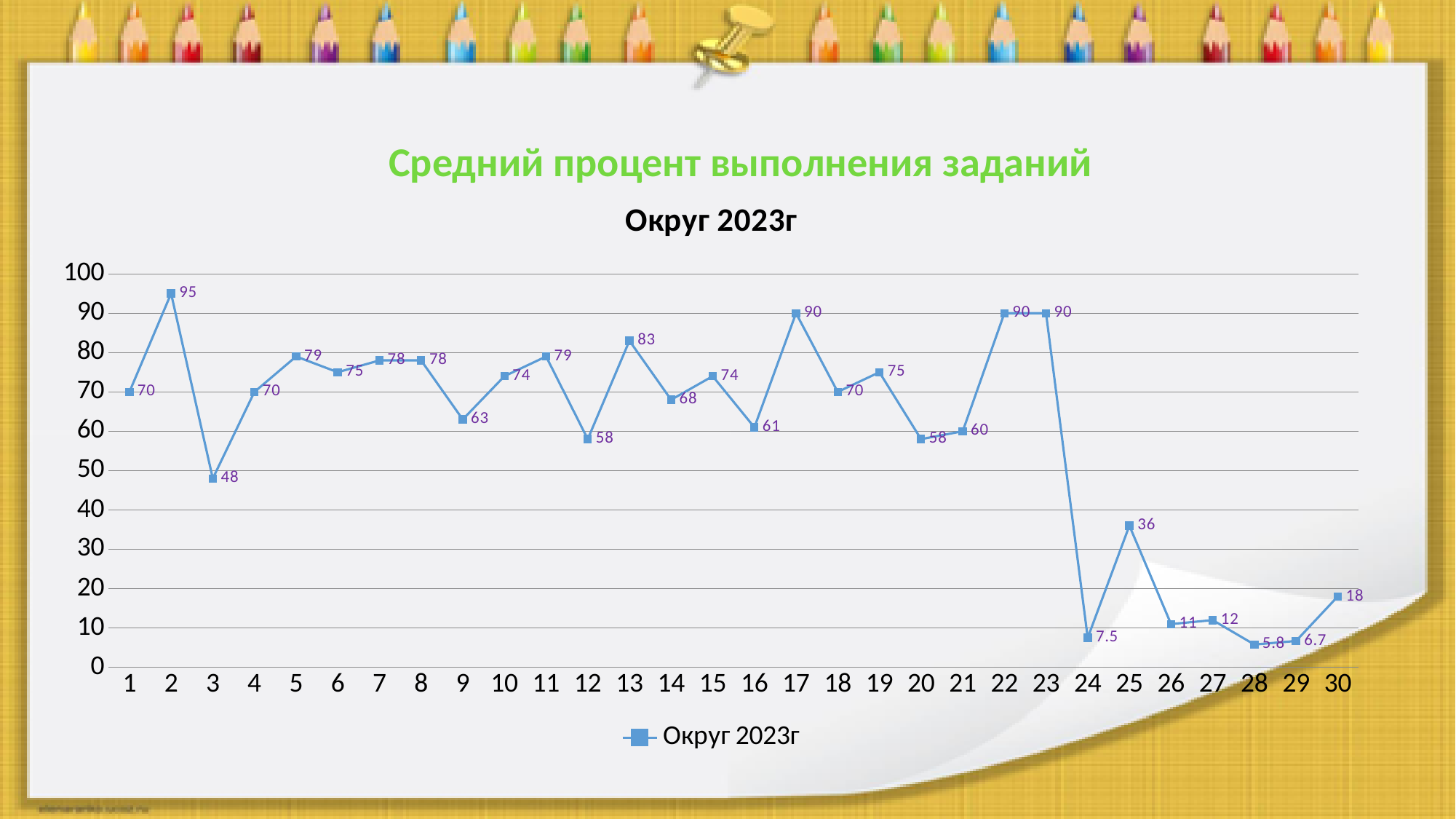
What is the difference between the values for category 2 and category 3? 47 Which is larger, the value for category 17 or the value for category 18? 17 What is the value for category 13? 83 Do the values rise or fall from category 23 to category 24? fall What is the value for category 24? 7.5 What is the value for category 2? 95 Which category has the lowest value? 28 What is the name of the series shown in the legend? Округ 2023г What kind of chart is shown? line chart How many categories are plotted on the x axis? 30 How many series does the legend list? 1 Which category has the highest value? 2